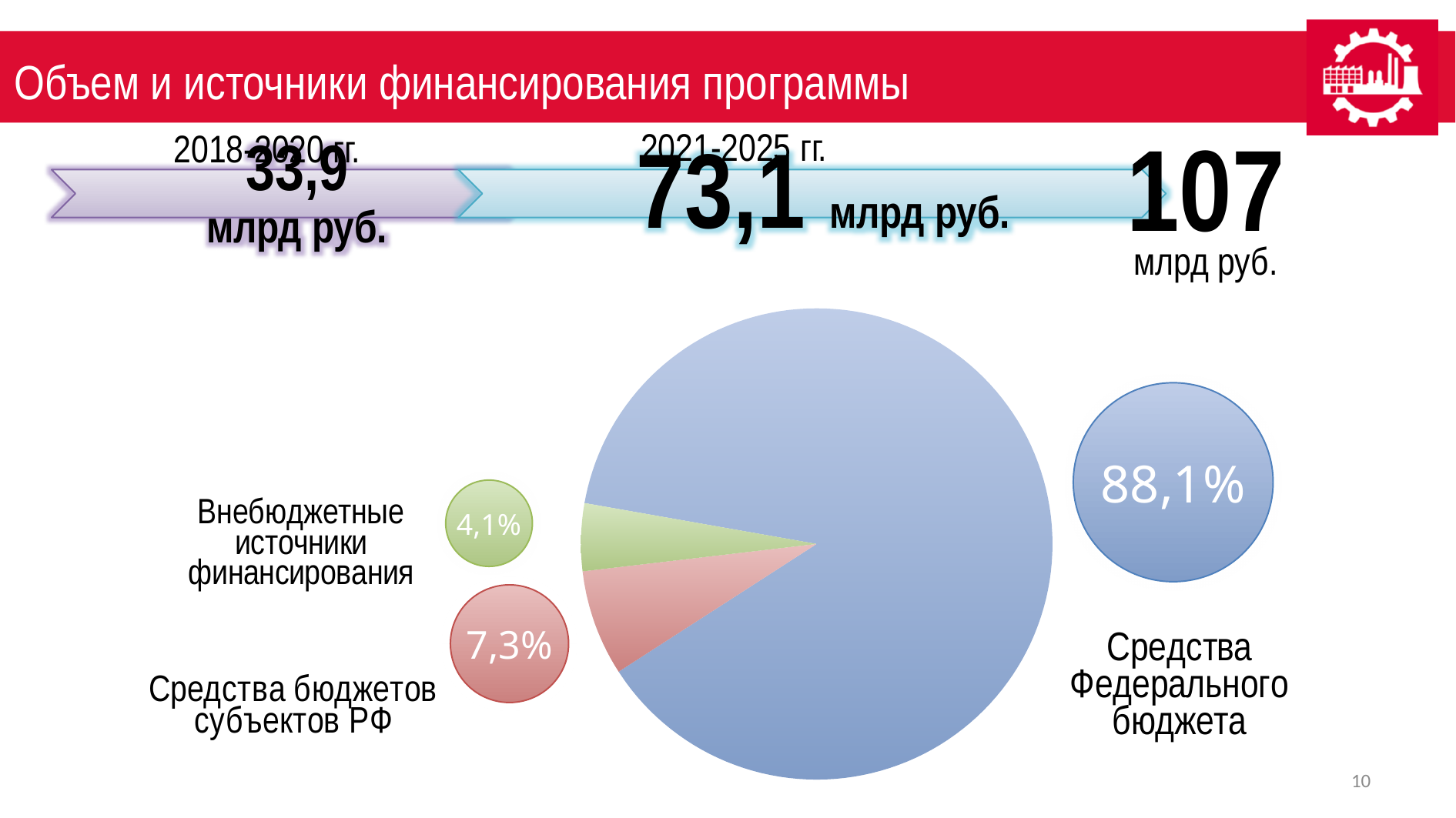
What is the difference in percentage points between the Средства бюджетов субъектов РФ slice and the Внебюджетные источники финансирования slice? 3,2 Which source has the smallest slice of the pie chart? Внебюджетные источники финансирования What share of the pie chart is labelled for Внебюджетные источники финансирования? 4,1% Which source has the largest slice of the pie chart? Средства Федерального бюджета How many slices does the pie chart have? 3 What share of the pie chart is labelled for Средства Федерального бюджета? 88,1% What kind of chart is shown on the slide? pie chart What is the difference in percentage points between the Средства Федерального бюджета slice and the Средства бюджетов субъектов РФ slice? 80,8 What colour is the Внебюджетные источники финансирования slice in the pie chart? green What colour is the Средства Федерального бюджета slice in the pie chart? blue Which is larger in the pie chart: Средства бюджетов субъектов РФ or Внебюджетные источники финансирования? Средства бюджетов субъектов РФ What share of the pie chart is labelled for Средства бюджетов субъектов РФ? 7,3%